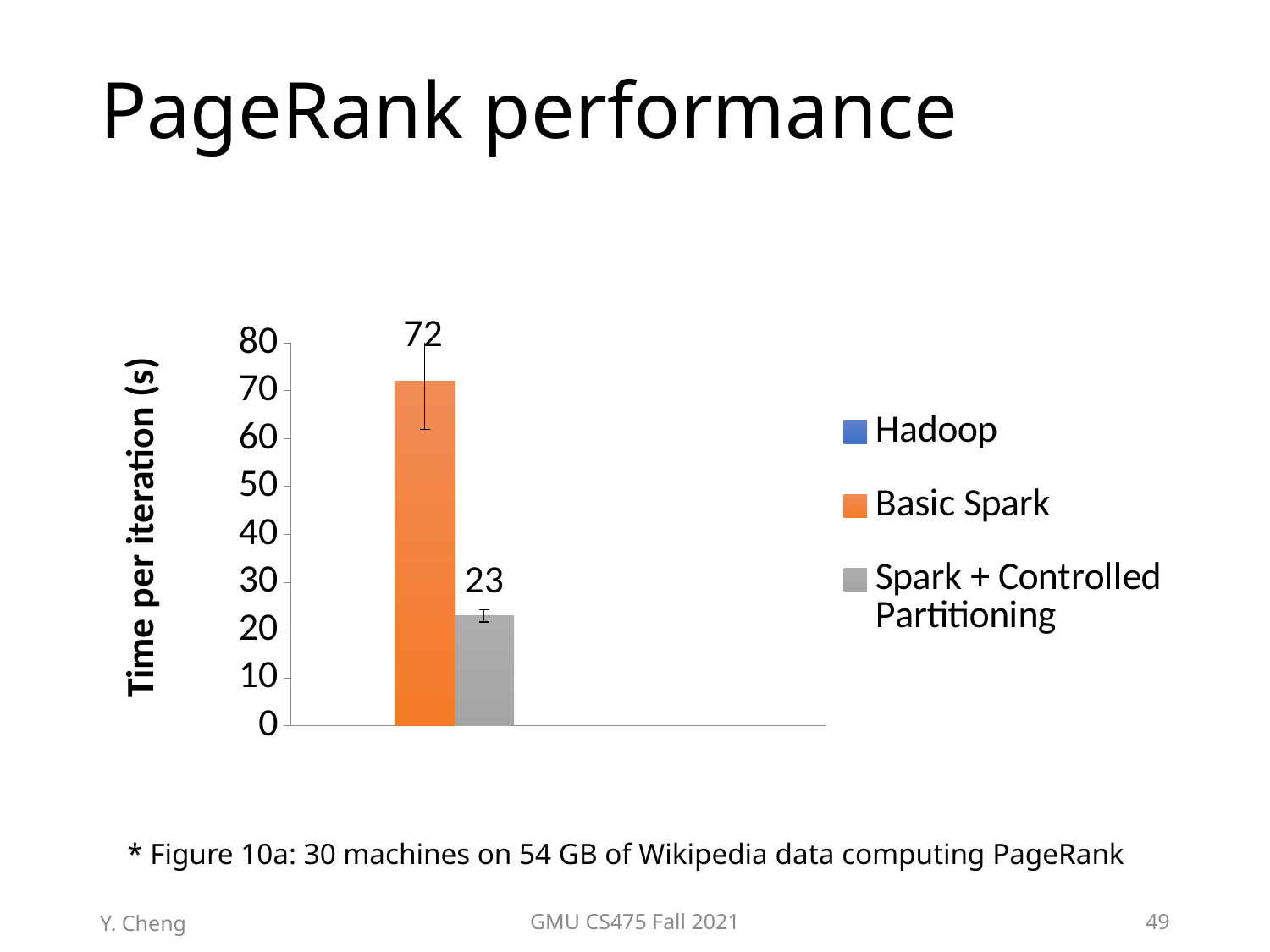
What is the label of the vertical axis? Time per iteration (s) Is the value for Spark + Controlled Partitioning greater or less than 30? less What is the time per iteration for Basic Spark? 72 What is the time per iteration for Spark + Controlled Partitioning? 23 Which plotted series has the highest time per iteration? Basic Spark Which plotted series has the lowest time per iteration? Spark + Controlled Partitioning What colour is the Basic Spark bar? Orange What kind of chart is shown on the slide? Bar chart Is the value for Basic Spark greater or less than 60? greater How many series does the legend list? 3 What is the difference in time per iteration between Basic Spark and Spark + Controlled Partitioning? 49 Which has a larger time per iteration, Basic Spark or Spark + Controlled Partitioning? Basic Spark